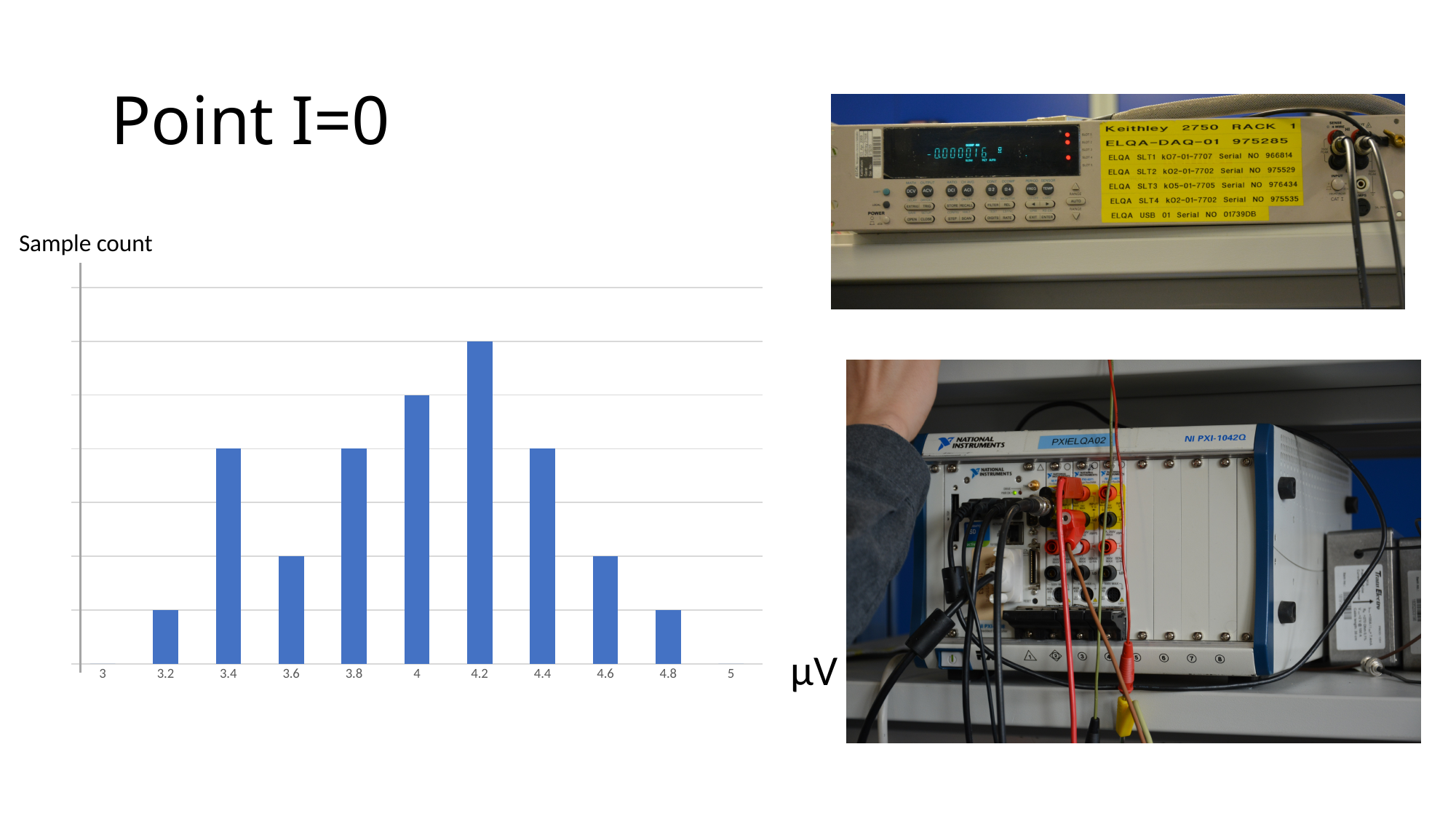
Do the bar heights rise or fall from 3.8 to 4.2 along the x axis? rise Which is larger, the bar at 4.2 or the bar at 4.6? 4.2 Which is larger, the bar at 4 or the bar at 4.4? 4 Which x-axis category has the highest bar? 4.2 What is the label on the vertical axis of the chart? Sample count Do the bar heights rise or fall from 4.2 to 4.8 along the x axis? fall How many categories are labelled on the x axis of the chart? 11 What kind of chart is shown on the slide? bar chart Which is larger, the bar at 3.4 or the bar at 3.6? 3.4 How many bars are visible in the chart? 9 What unit is shown next to the x axis of the chart? µV